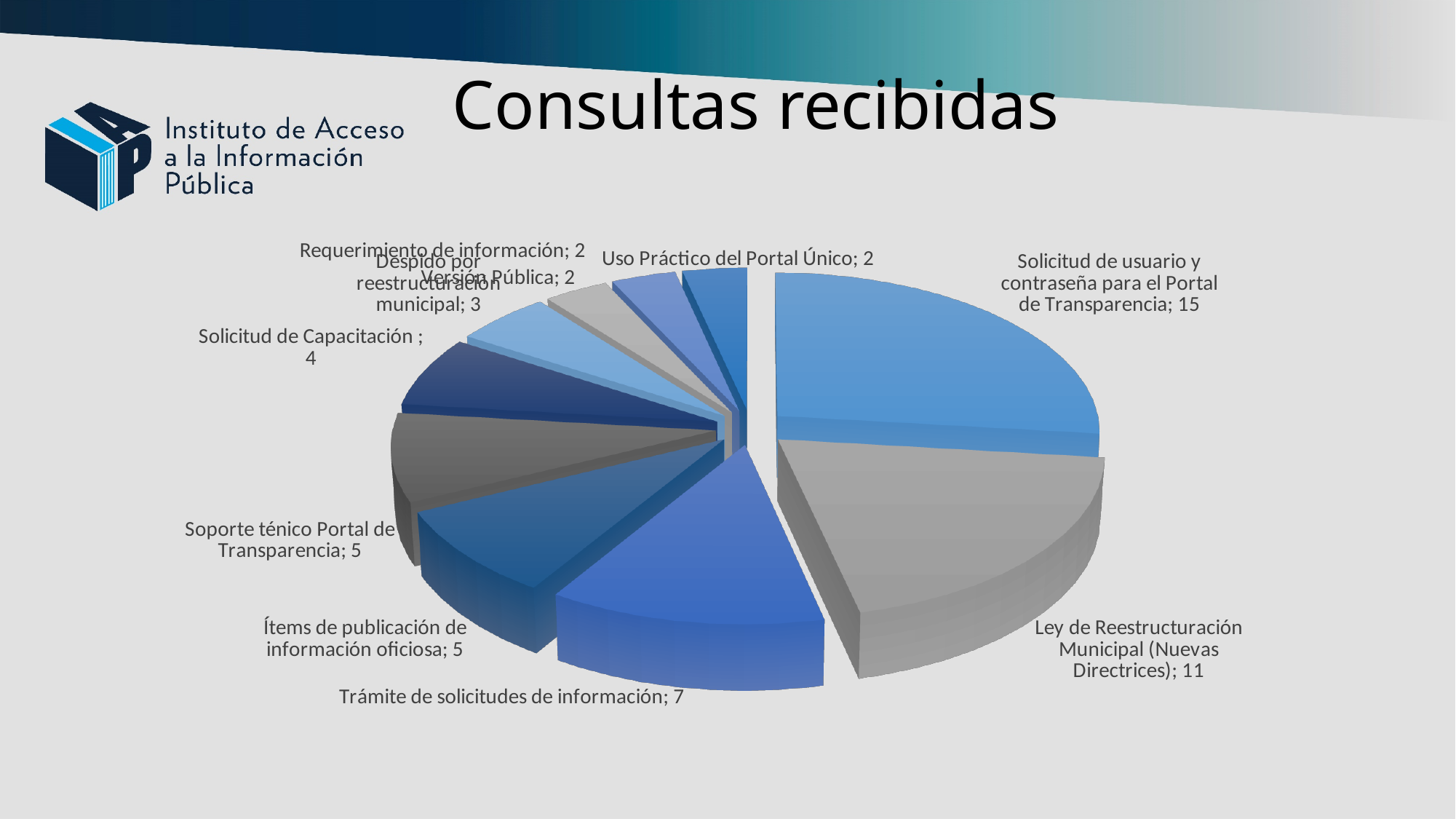
What is the title of the chart? Consultas recibidas What is the value for 'Solicitud de usuario y contraseña para el Portal de Transparencia'? 15 What is the value for 'Trámite de solicitudes de información'? 7 What is the total of all the values shown in the pie chart? 56 What is the difference between the values for 'Solicitud de usuario y contraseña para el Portal de Transparencia' and 'Ley de Reestructuración Municipal (Nuevas Directrices)'? 4 What is the value for 'Ley de Reestructuración Municipal (Nuevas Directrices)'? 11 What is the value for 'Uso Práctico del Portal Único'? 2 What is the value for 'Solicitud de Capacitación'? 4 How many slices does the pie chart have? 10 What kind of chart is shown on the slide? Pie chart Which is larger: 'Trámite de solicitudes de información' or 'Soporte ténico Portal de Transparencia'? Trámite de solicitudes de información Which category has the largest slice of the pie? Solicitud de usuario y contraseña para el Portal de Transparencia